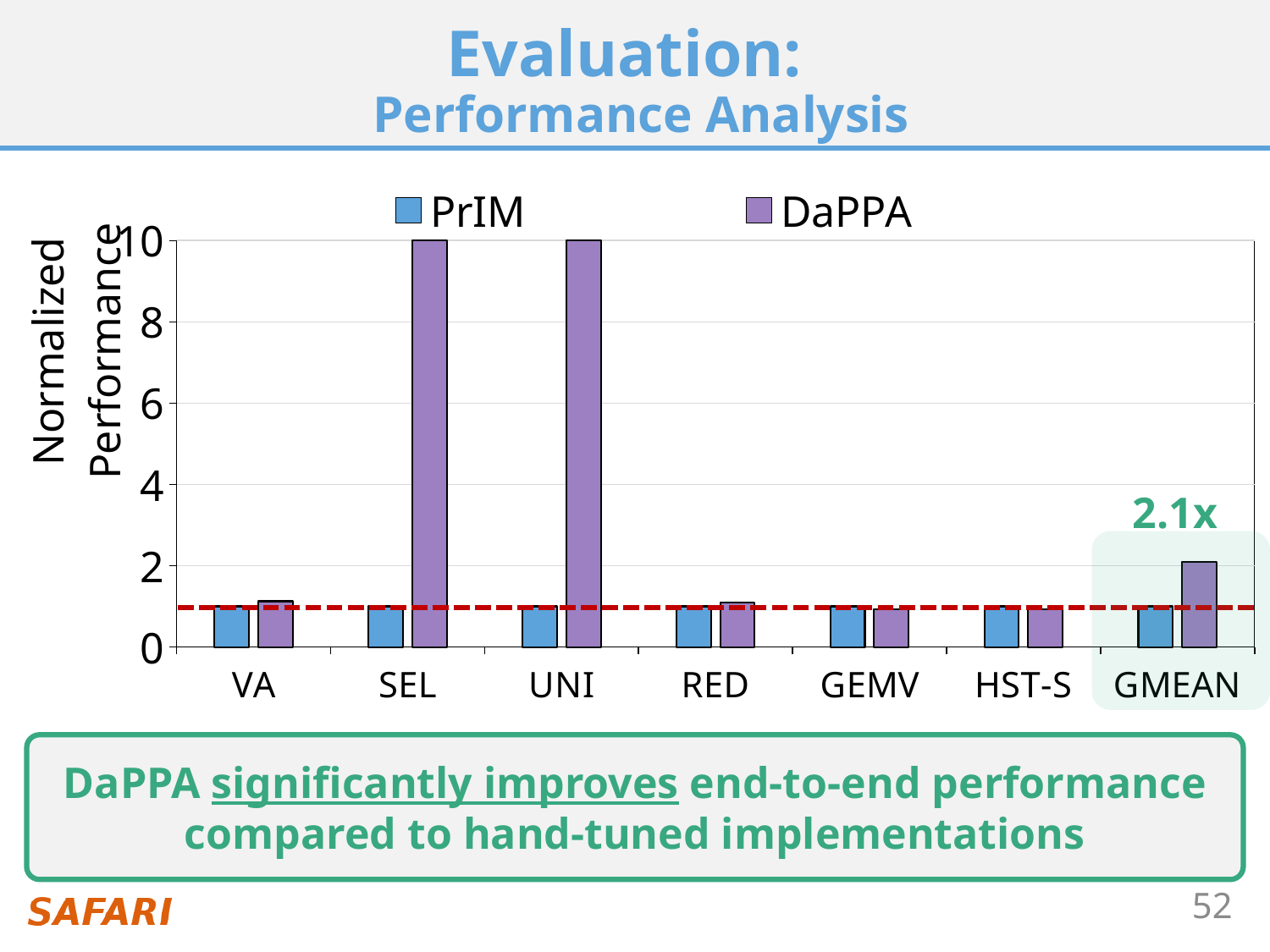
Which is larger, the DaPPA value for SEL or the DaPPA value for RED? SEL How many series does the legend list? 2 What kind of chart is shown on the slide? bar chart Is the DaPPA value for UNI greater or less than 6? greater What is the label of the y axis? Normalized Performance What value is labelled above the DaPPA bar for GMEAN? 2.1x What are the two series named in the legend? PrIM and DaPPA For GMEAN, which series has the larger value, PrIM or DaPPA? DaPPA How many categories are shown on the x axis? 7 Is the DaPPA value for SEL greater or less than 8? greater Is the DaPPA value for VA greater or less than 2? less